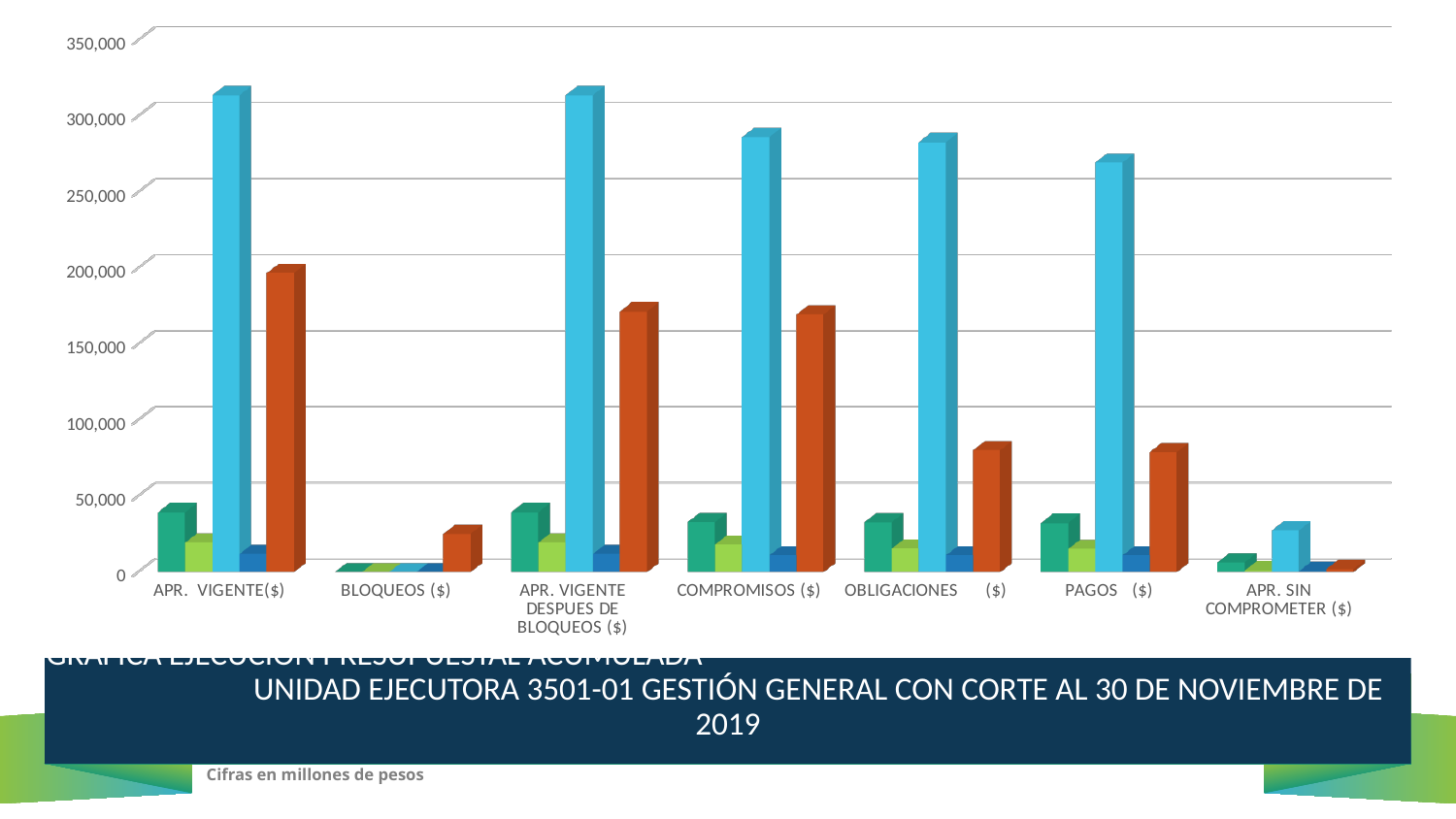
How many categories are shown along the x axis of the chart? 7 Is the value of the orange bar for APR. VIGENTE($) greater or less than 150,000? greater Is the value of the light blue bar for COMPROMISOS ($) greater or less than 300,000? less Among the orange bars, which category has the highest value? APR. VIGENTE($) Among the light blue bars, which category has the lowest value? BLOQUEOS ($) What is the highest value shown on the vertical axis of the chart? 350,000 Is the value of the tallest (light blue) bar for APR. VIGENTE($) greater or less than 300,000? greater Which is larger: the orange bar for APR. VIGENTE($) or the orange bar for COMPROMISOS ($)? APR. VIGENTE($) What kind of chart is shown on the slide? bar chart